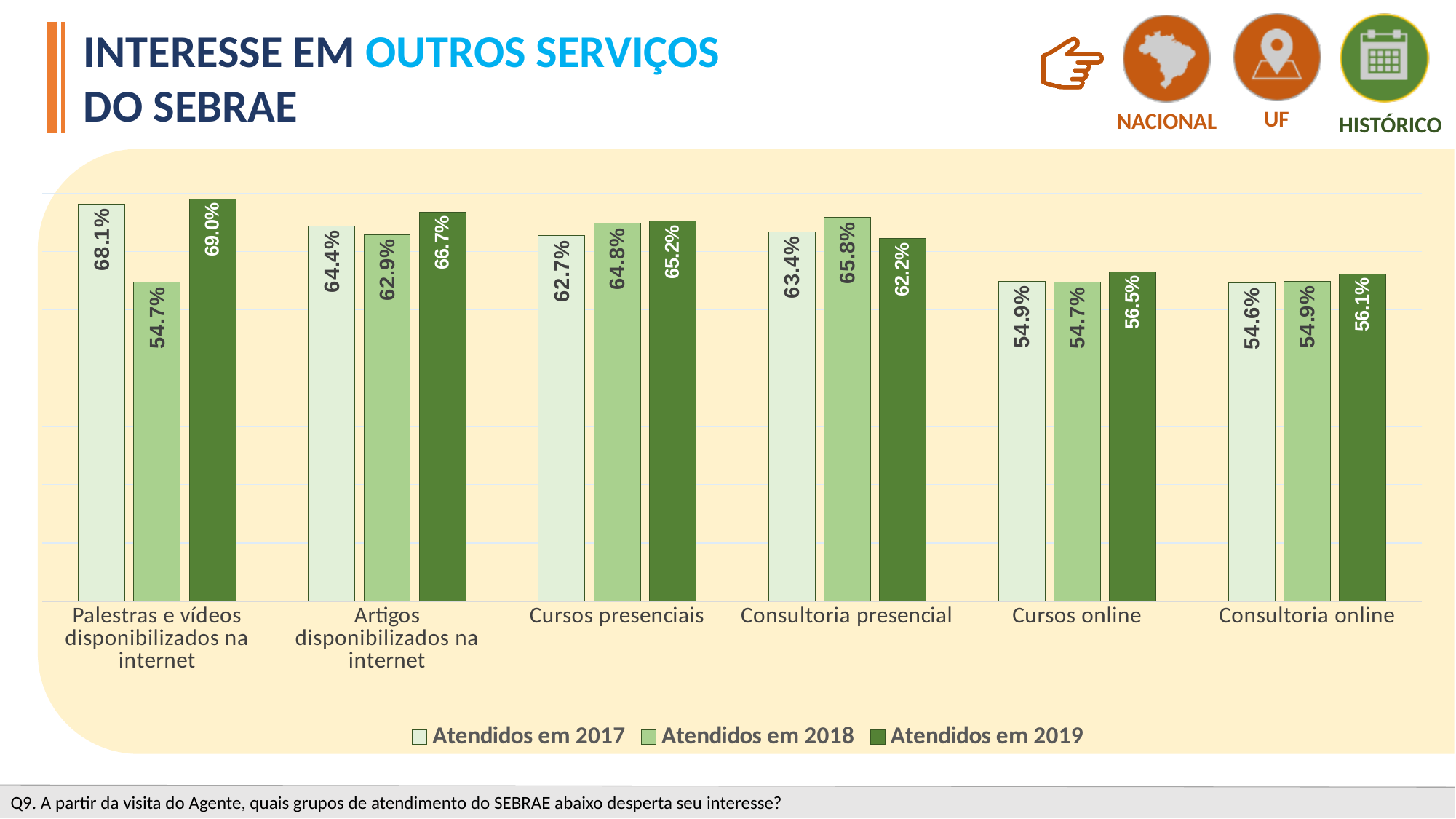
What is the value for 'Palestras e vídeos disponibilizados na internet' in the 'Atendidos em 2019' series? 69.0% What is the difference between the 'Atendidos em 2017' and 'Atendidos em 2018' values for 'Palestras e vídeos disponibilizados na internet'? 13.4% Which category has the highest value in the 'Atendidos em 2019' series? Palestras e vídeos disponibilizados na internet Do the 'Atendidos em 2019' values rise or fall from 'Palestras e vídeos disponibilizados na internet' to 'Consultoria online'? Fall Which category has the lowest value in the 'Atendidos em 2018' series? Palestras e vídeos disponibilizados na internet and Cursos online (tied at 54.7%) Which is larger for 'Consultoria presencial': the 'Atendidos em 2018' value or the 'Atendidos em 2019' value? Atendidos em 2018 How many categories are shown on the x axis? 6 What is the name of the third series in the legend? Atendidos em 2019 What is the value for 'Consultoria online' in the 'Atendidos em 2017' series? 54.6% How many series does the legend list? 3 What is the value for 'Cursos presenciais' in the 'Atendidos em 2018' series? 64.8% What kind of chart is shown on the slide? Bar chart